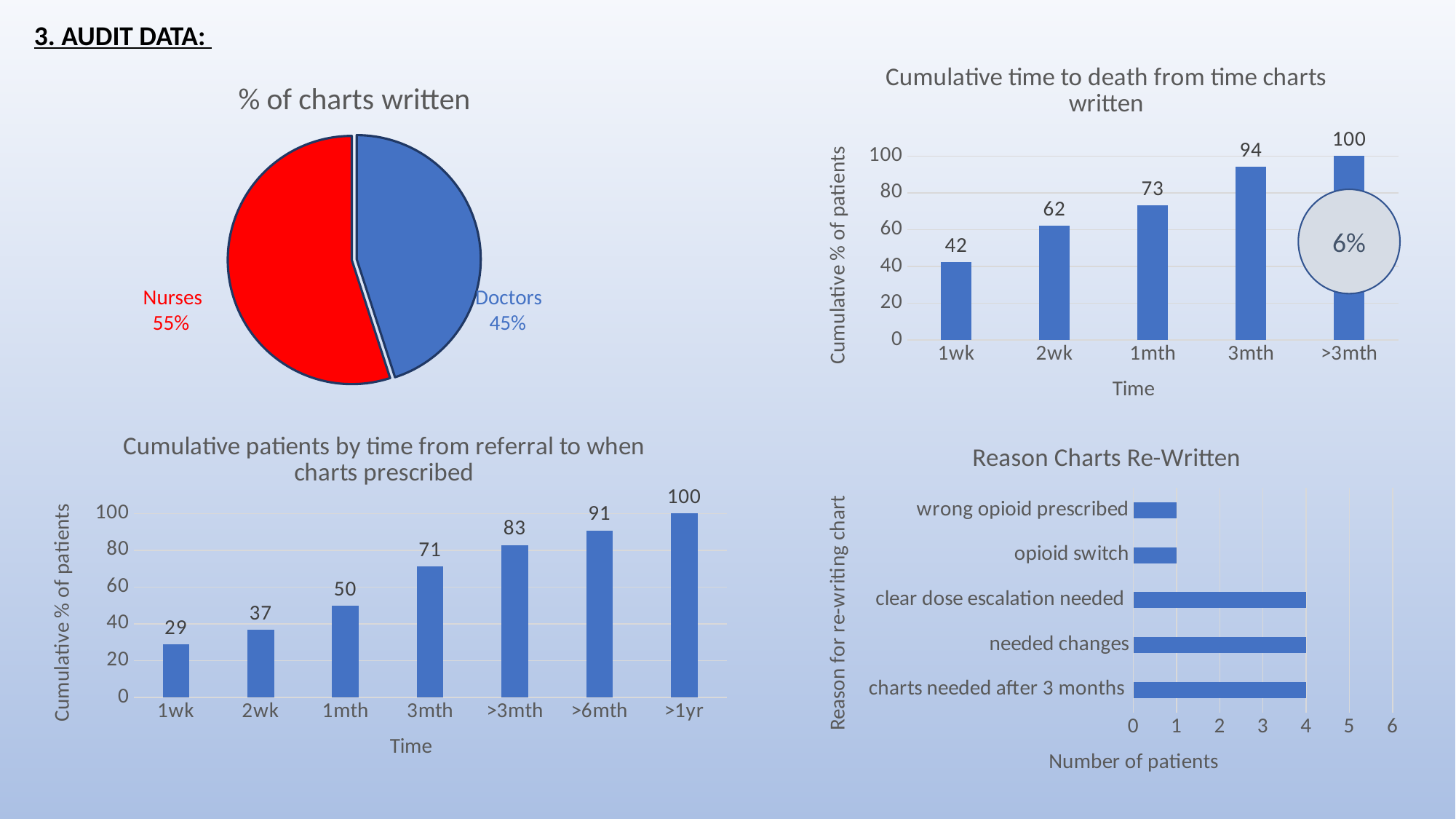
In the 'Cumulative time to death from time charts written' chart, which time category has the lowest value? 1wk In the 'Cumulative time to death from time charts written' chart, what kind of chart is shown? Bar chart In the 'Reason Charts Re-Written' chart, how many patients are shown for 'opioid switch'? 1 In the '% of charts written' pie chart, what share of charts were written by Nurses? 55% In the 'Cumulative time to death from time charts written' chart, what is the cumulative % of patients at 2wk? 62 In the 'Cumulative patients by time from referral to when charts prescribed' chart, what is the value at 3mth? 71 In the 'Cumulative time to death from time charts written' chart, what is the difference between the values at 3mth and 1mth? 21 In the '% of charts written' pie chart, which group wrote the larger share of charts, Nurses or Doctors? Nurses In the 'Cumulative patients by time from referral to when charts prescribed' chart, do the values rise or fall from 1wk to >1yr? Rise In the 'Cumulative patients by time from referral to when charts prescribed' chart, what is the difference between the values at >6mth and >3mth? 8 In the 'Cumulative patients by time from referral to when charts prescribed' chart, how many time categories are shown on the x axis? 7 In the 'Reason Charts Re-Written' chart, how many reasons are listed on the vertical axis? 5